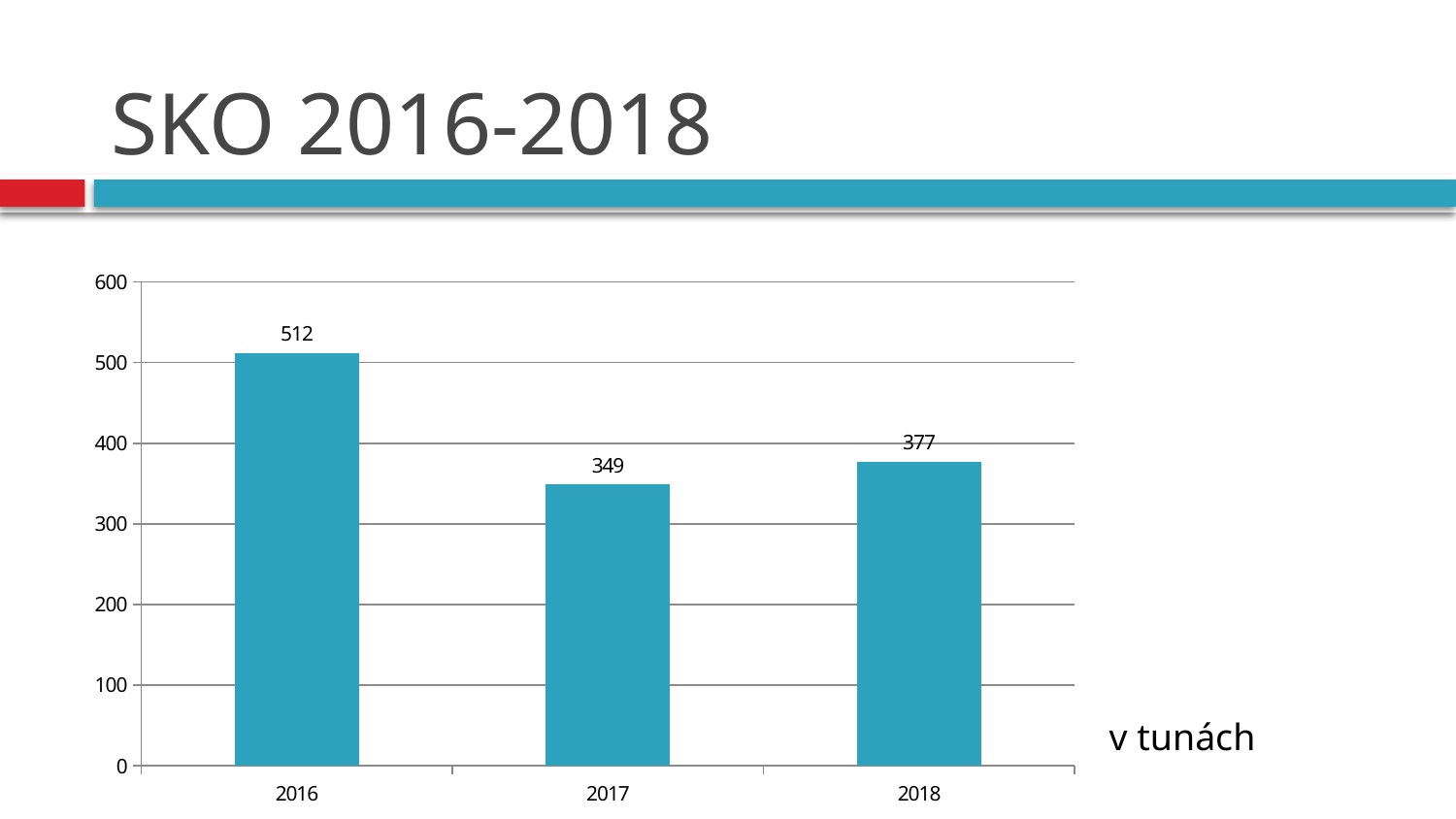
What is the value for 2017? 349 What unit label is shown next to the chart? v tunách Is the value for 2017 greater or less than 400? less What is the difference between the values for 2016 and 2017? 163 What is the value for 2018? 377 What kind of chart is shown on the slide? bar chart How many years are shown on the x axis? 3 Which year has the lowest value? 2017 Which is larger, the value for 2016 or the value for 2018? 2016 Which year has the highest value? 2016 What is the value for 2016? 512 What is the difference between the values for 2018 and 2017? 28